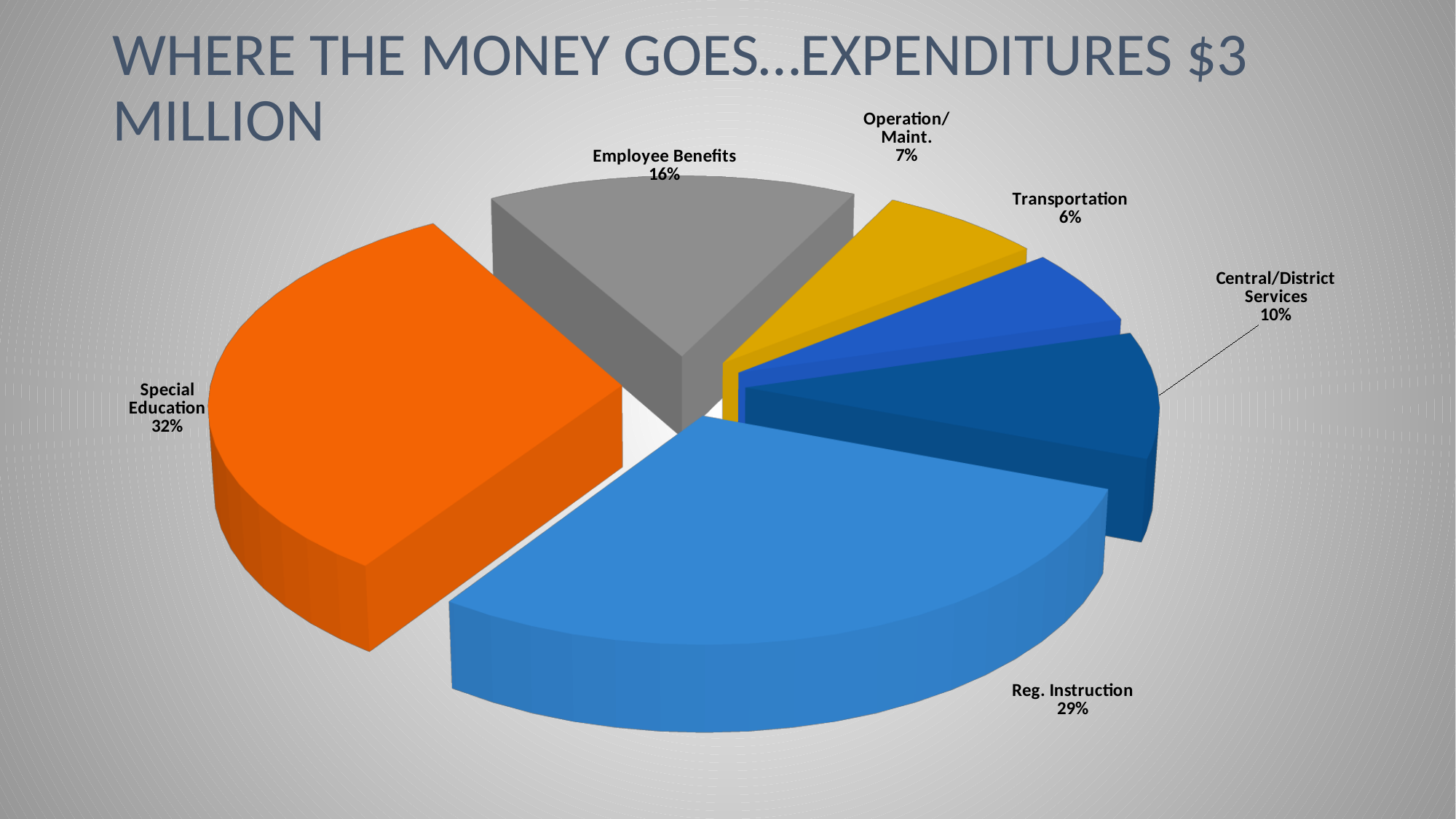
What percentage of expenditures is Reg. Instruction? 29% Which category has the smallest share of expenditures? Transportation What percentage is shown for Transportation? 6% What is the difference in percentage points between Special Education and Reg. Instruction? 3 What share of expenditures is Employee Benefits? 16% How many categories are shown in the pie chart? 6 Which category has the largest share of expenditures? Special Education Which is larger, Employee Benefits or Central/District Services? Employee Benefits What share of expenditures goes to Special Education? 32% What percentage is shown for Central/District Services? 10% What is the title of the slide? WHERE THE MONEY GOES...EXPENDITURES $3 MILLION What kind of chart is shown on the slide? Pie chart